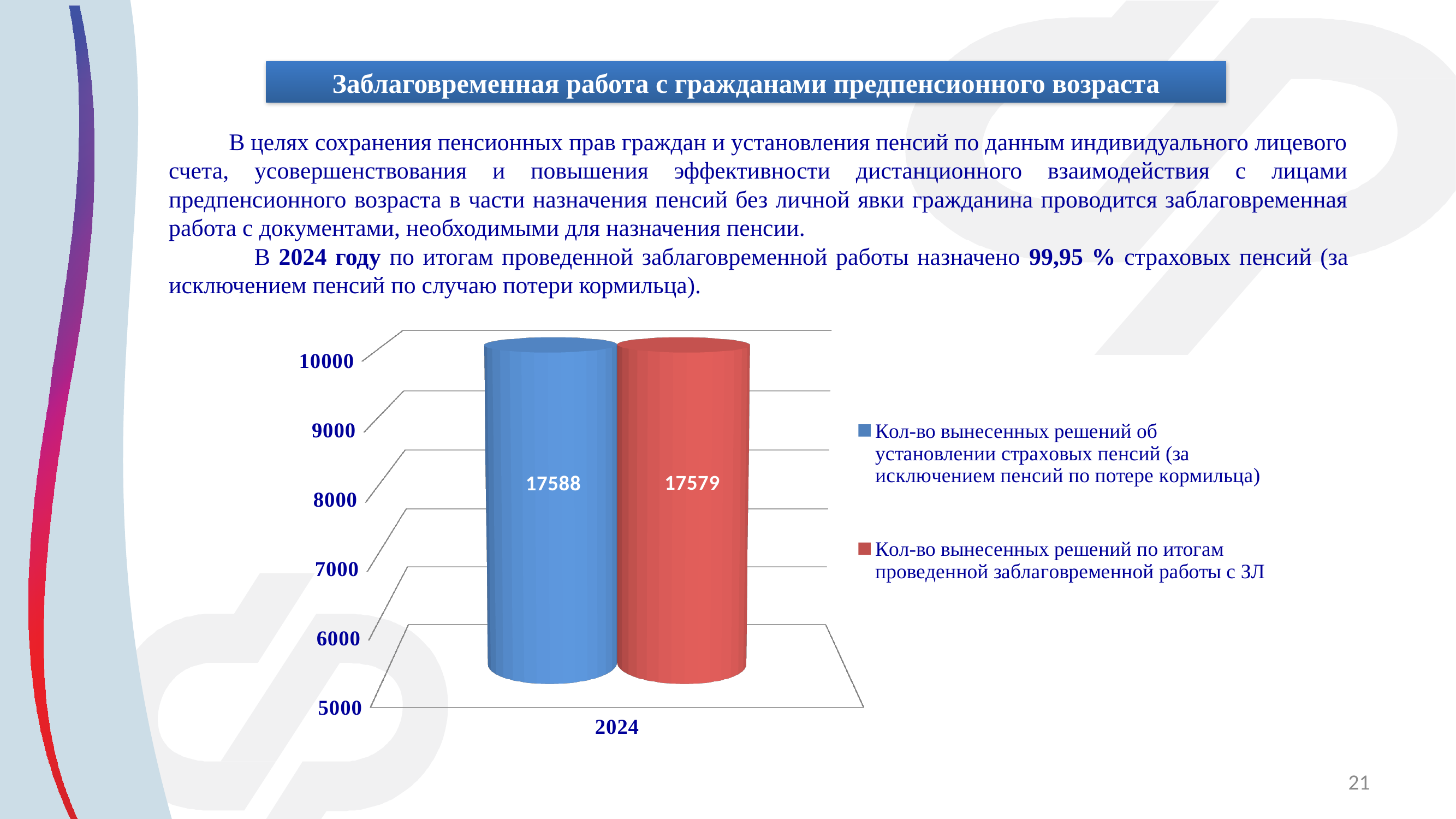
Which series has the larger value in 2024, the blue one or the red one? The blue one (17588) What is the value of the blue series (Кол-во вынесенных решений об установлении страховых пенсий) for 2024? 17588 What is the difference between the blue bar value and the red bar value? 9 What kind of chart is shown on the slide? Bar chart Which series has the lowest value on the chart? Кол-во вынесенных решений по итогам проведенной заблаговременной работы с ЗЛ What is the value of the red series (Кол-во вынесенных решений по итогам проведенной заблаговременной работы с ЗЛ) for 2024? 17579 How many series does the legend list? 2 How many categories are shown on the x axis? 1 What colour represents the series 'Кол-во вынесенных решений по итогам проведенной заблаговременной работы с ЗЛ'? Red Is the value of the red bar greater or less than 10000? greater What is the category label shown on the x axis? 2024 Which series has the highest value on the chart? Кол-во вынесенных решений об установлении страховых пенсий (за исключением пенсий по потере кормильца)